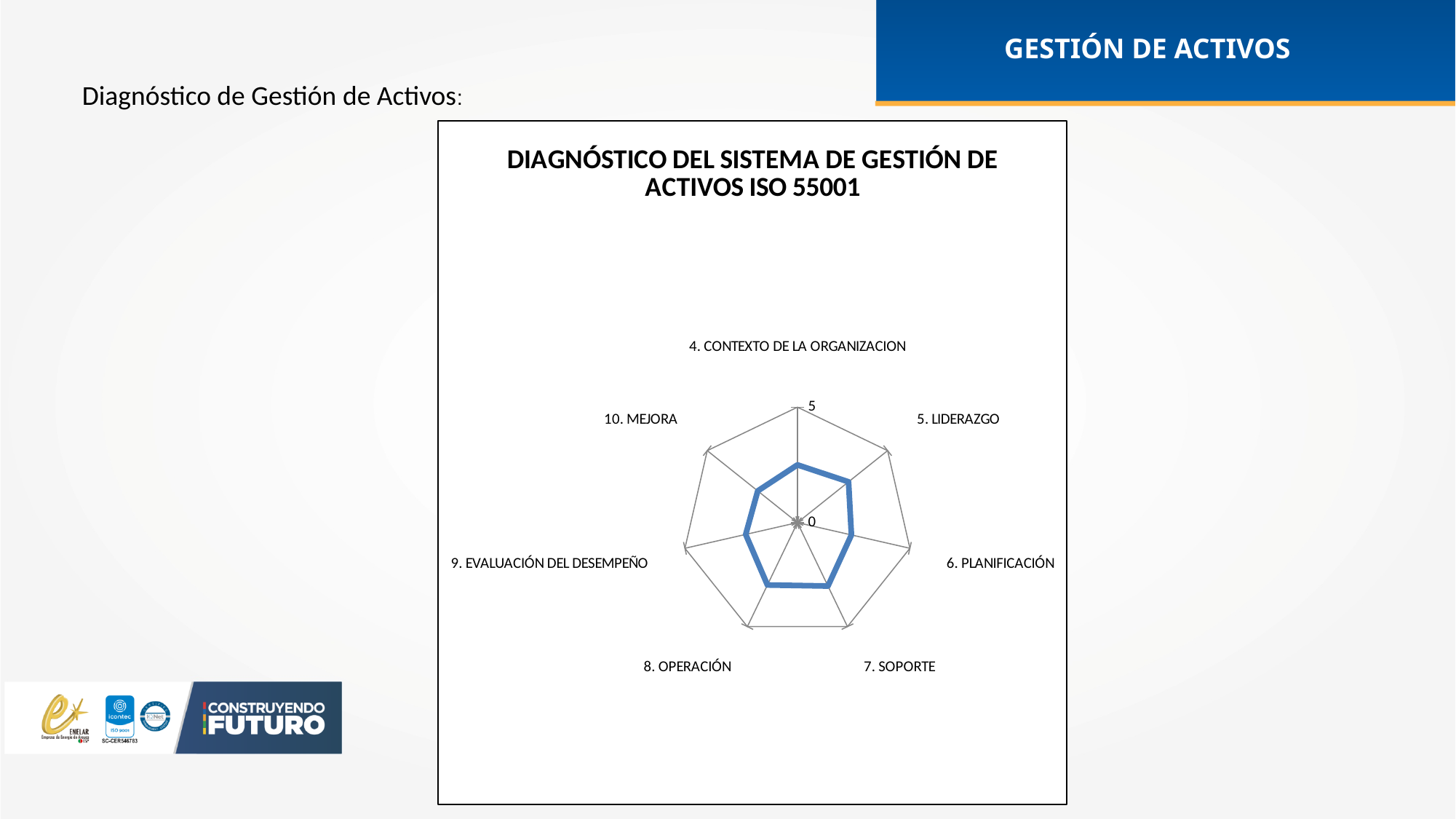
Is the value for 10. MEJORA greater or less than 5? less Is the value for 4. CONTEXTO DE LA ORGANIZACION greater or less than 5? less Is the value for 9. EVALUACIÓN DEL DESEMPEÑO greater or less than 0? greater What kind of chart is shown on the slide? Radar chart What is the maximum value shown on the radar chart's axis scale? 5 What is the title of the chart? DIAGNÓSTICO DEL SISTEMA DE GESTIÓN DE ACTIVOS ISO 55001 How many categories (axes) does the radar chart have? 7